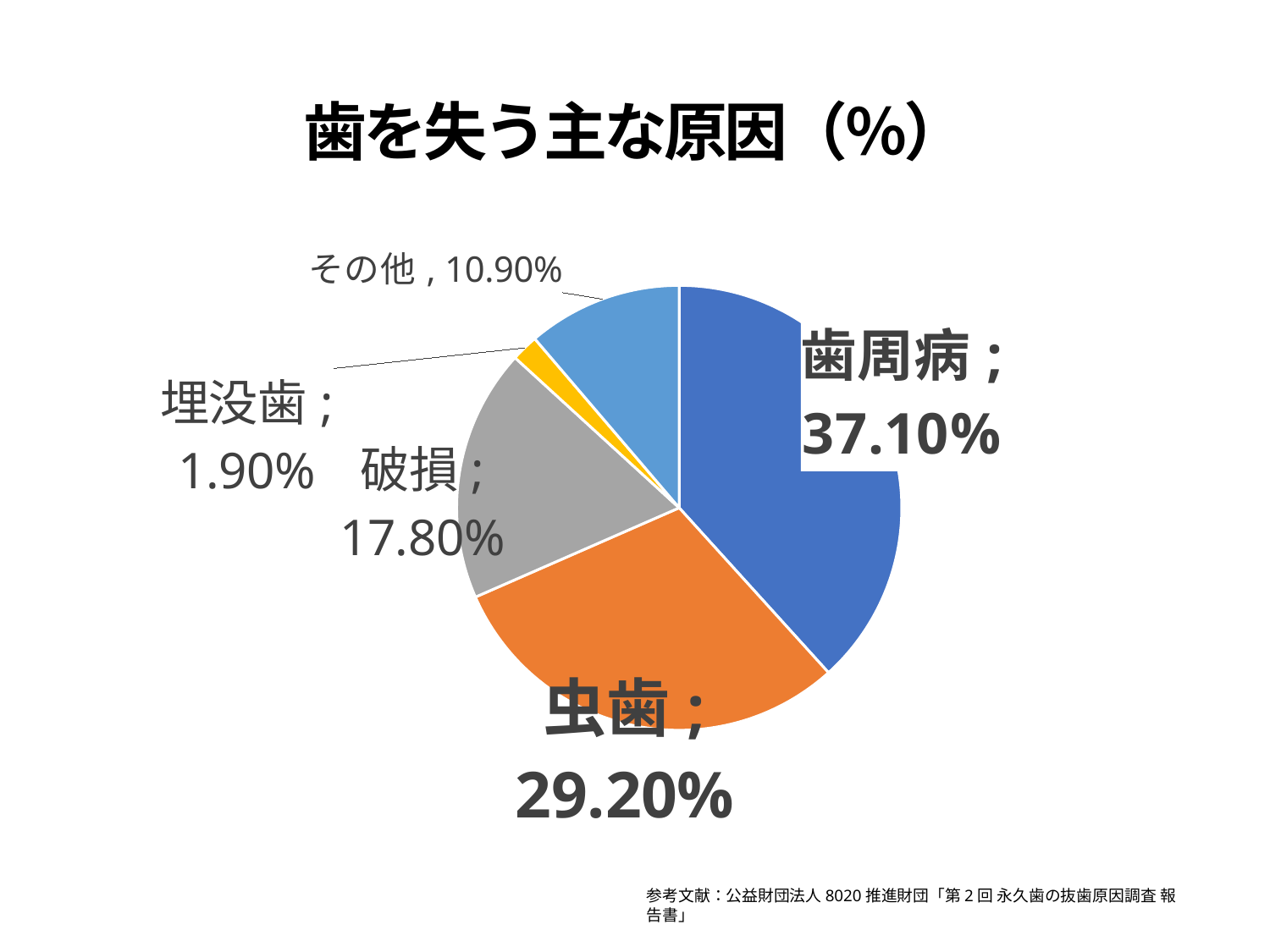
What is the value for その他? 10.90% What is the value for 歯周病? 37.10% What is the difference between the values for 歯周病 and 虫歯? 7.90% Which category has the smallest share of the pie? 埋没歯 What is the value for 埋没歯? 1.90% Which category has the largest share of the pie? 歯周病 How many slices does the pie chart have? 5 Which is larger, the value for 破損 or the value for その他? 破損 What is the value for 破損? 17.80% What is the title of the chart? 歯を失う主な原因（%） What kind of chart is shown on the slide? Pie chart What is the value for 虫歯? 29.20%